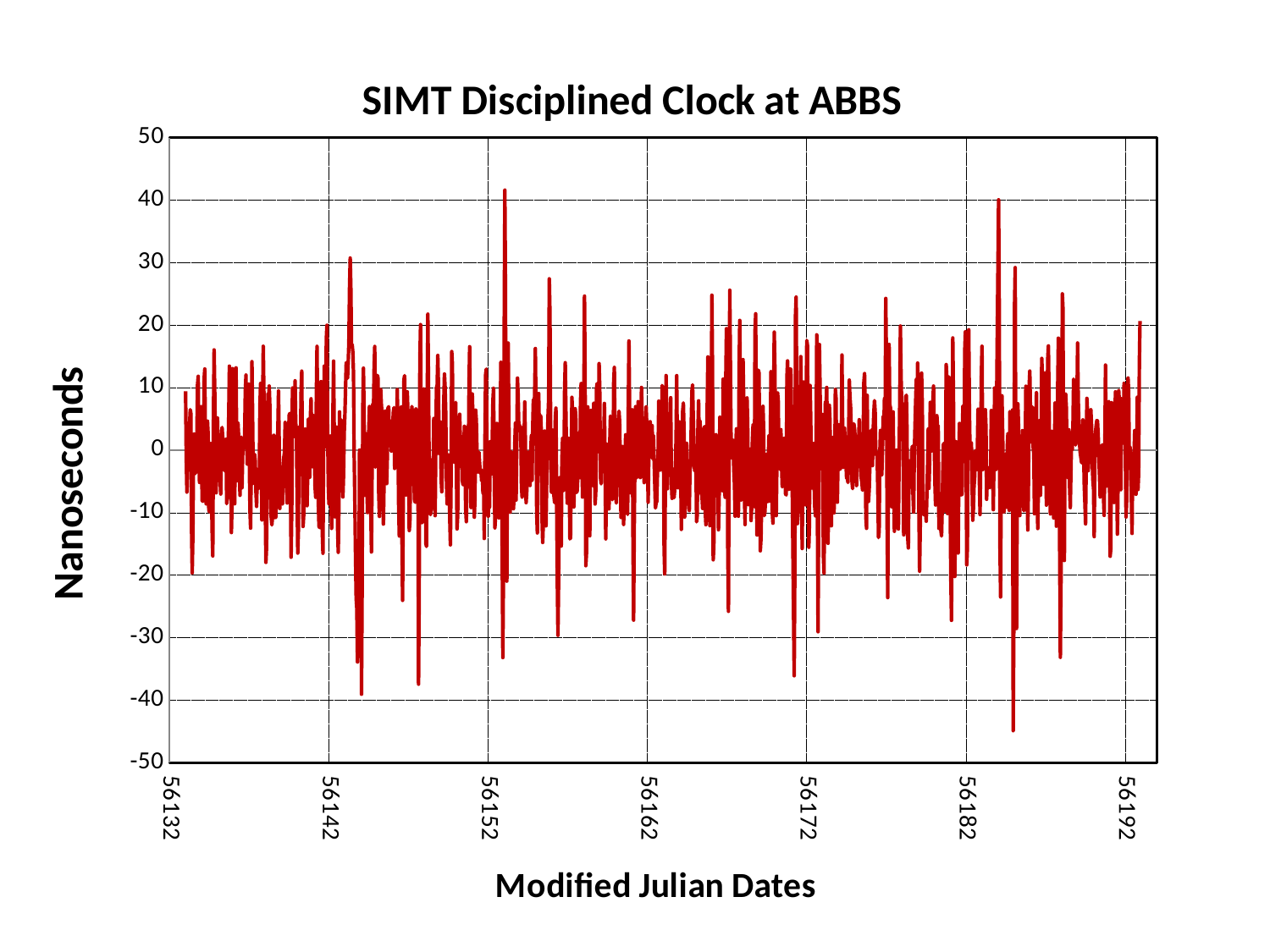
Is the highest value plotted on the chart greater or less than 50? less How many series are plotted on the chart? 1 What kind of chart is shown on the slide? line chart Is the lowest value plotted on the chart greater or less than -50? greater Is the lowest value plotted on the chart greater or less than -40? less Do the values show a clear rising or falling trend along the x axis? neither; they fluctuate around 0 What is the title of the chart? SIMT Disciplined Clock at ABBS What is the label of the x axis? Modified Julian Dates How many tick labels are shown on the x axis? 7